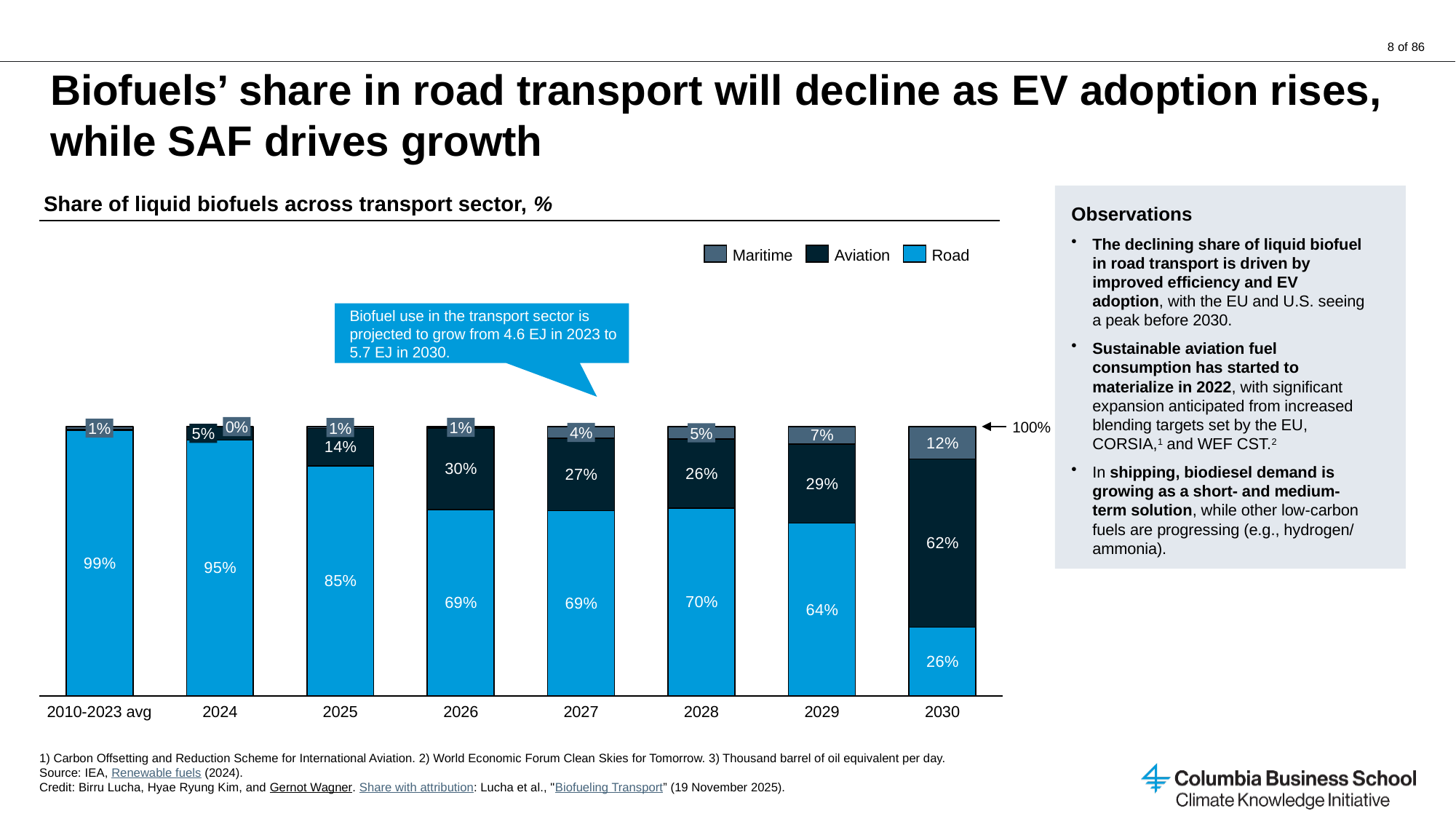
What is the Road share for the 2010-2023 avg? 99% What is the Aviation share in 2026? 30% What is the Maritime share in 2029? 7% How many categories are shown on the x axis? 8 What is the Road share in 2030? 26% What kind of chart is shown on the slide? Stacked bar chart How many series does the legend list? 3 Which year has the highest Aviation share? 2030 Does the Road share generally rise or fall from the 2010-2023 avg to 2030? Fall What is the difference between the Road share in 2025 and the Road share in 2029? 21% In 2030, which is larger: the Aviation share or the Road share? Aviation Which category has the lowest Road share? 2030